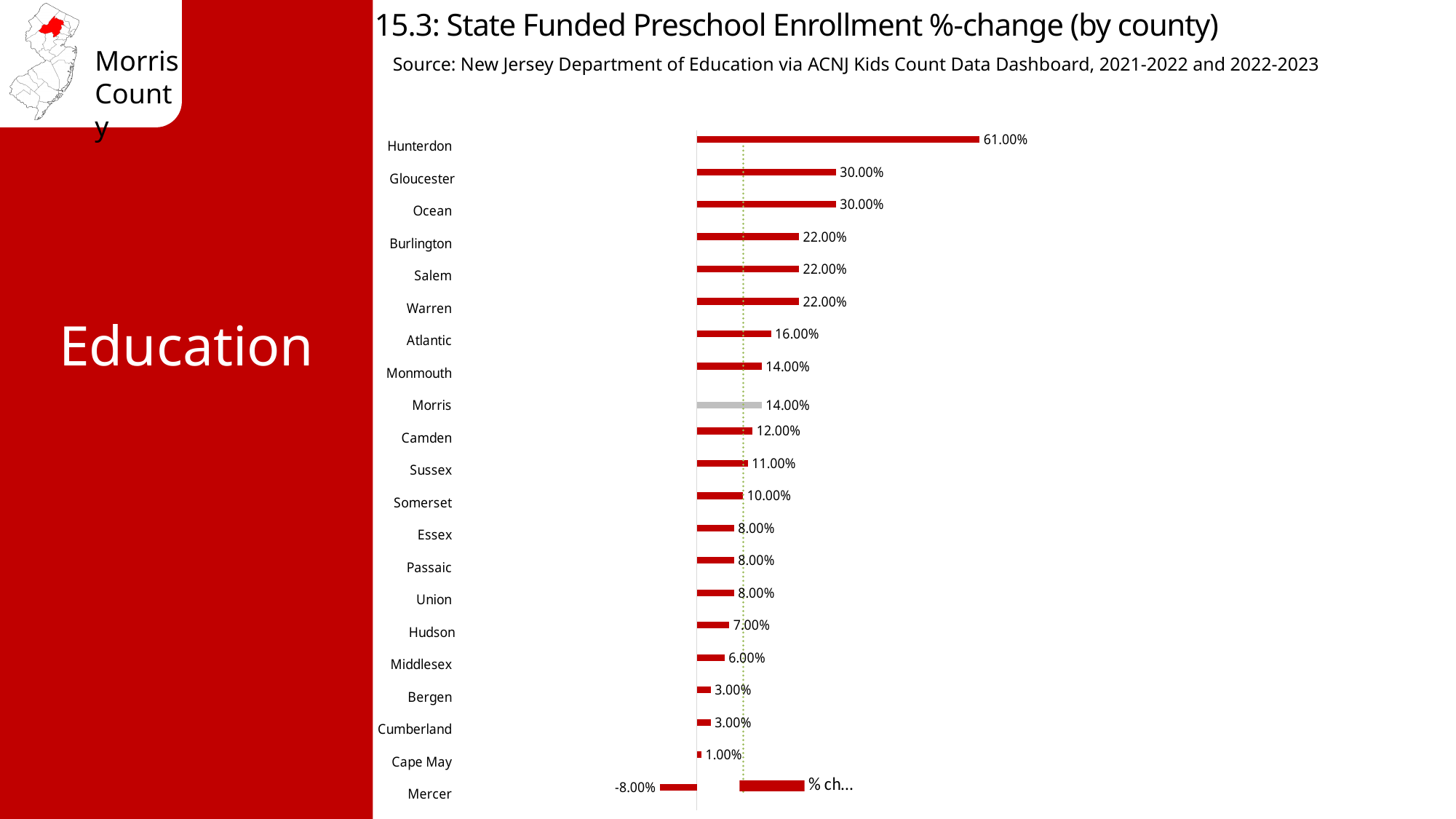
How many counties are shown in the chart? 21 What is the difference between the %-change for Hunterdon and the %-change for Gloucester? 31.00% What is the difference between the %-change for Morris and the %-change for Mercer? 22.00% What kind of chart is used on this slide? Bar chart What is the state funded preschool enrollment %-change for Hunterdon? 61.00% What is the %-change value shown for Cape May? 1.00% Which county has the highest state funded preschool enrollment %-change? Hunterdon Which county has the lowest state funded preschool enrollment %-change? Mercer Which county's bar is coloured grey instead of red? Morris What is the %-change value shown for Mercer? -8.00% Which county has a larger %-change, Atlantic or Camden? Atlantic What is the %-change value shown for Morris? 14.00%